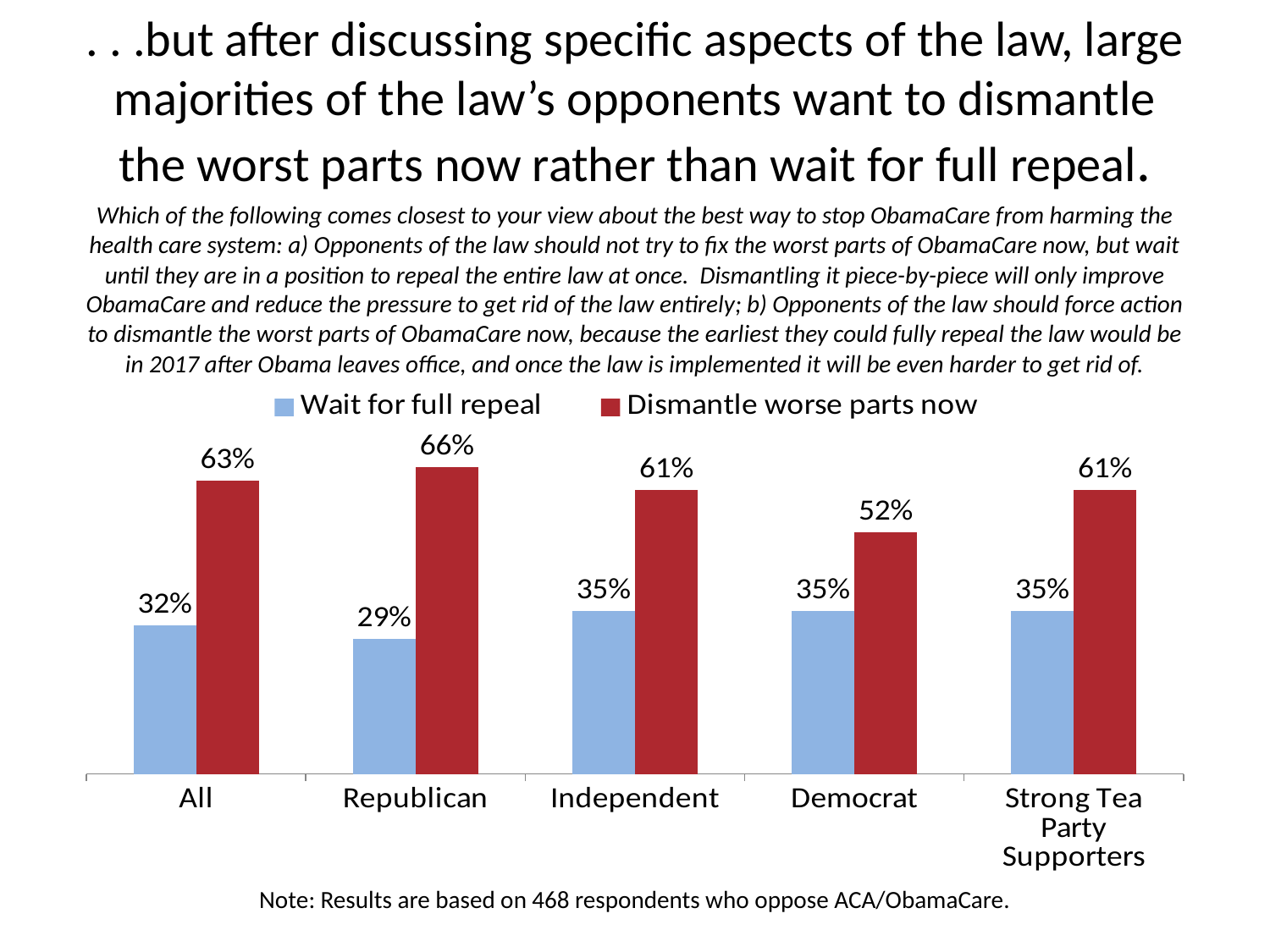
How many series does the legend list? 2 Which category has the highest "Dismantle worse parts now" value? Republican What is the difference between the "Dismantle worse parts now" values for Independent and Democrat? 9 percentage points What is the difference between the "Dismantle worse parts now" and "Wait for full repeal" values for Republicans? 37 percentage points What is the "Wait for full repeal" value for the All category? 32% What percentage of Democrats chose "Dismantle worse parts now"? 52% What percentage of Republicans chose "Dismantle worse parts now"? 66% What kind of chart is shown on the slide? Bar chart How many categories are shown on the x axis? 5 Which is larger for Democrats: "Wait for full repeal" or "Dismantle worse parts now"? Dismantle worse parts now Which category has the lowest "Dismantle worse parts now" value? Democrat Which category has the lowest "Wait for full repeal" value? Republican